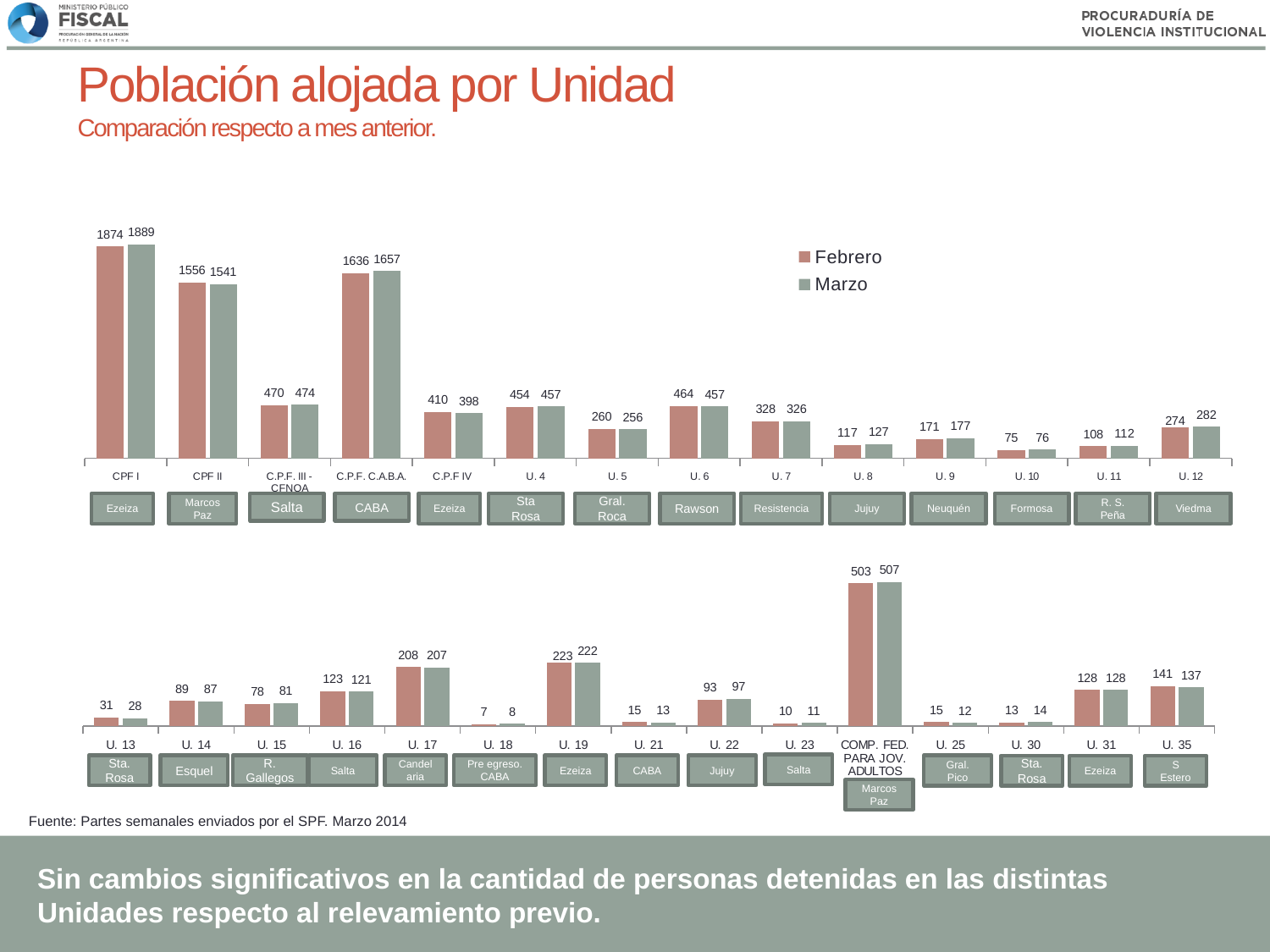
In the top chart, what is the Febrero value for U. 8? 117 In the top chart, what is the difference between the Febrero and Marzo values for C.P.F IV? 12 In the bottom chart, is the Febrero value for U. 17 larger or the Febrero value for U. 19? U. 19 In the top chart, which category has the lowest Marzo value? U. 10 In the bottom chart, which category has the lowest Febrero value? U. 18 How many series does the legend list? 2 In the top chart, how many categories are shown on the x axis? 14 In the bottom chart, how many categories are shown on the x axis? 15 In the bottom chart, what is the Marzo value for COMP. FED. PARA JOV. ADULTOS? 507 In the top chart, which category has the highest Febrero value? CPF I In the top chart, what is the Marzo value for CPF I? 1889 What kind of chart is used on this slide? Bar chart